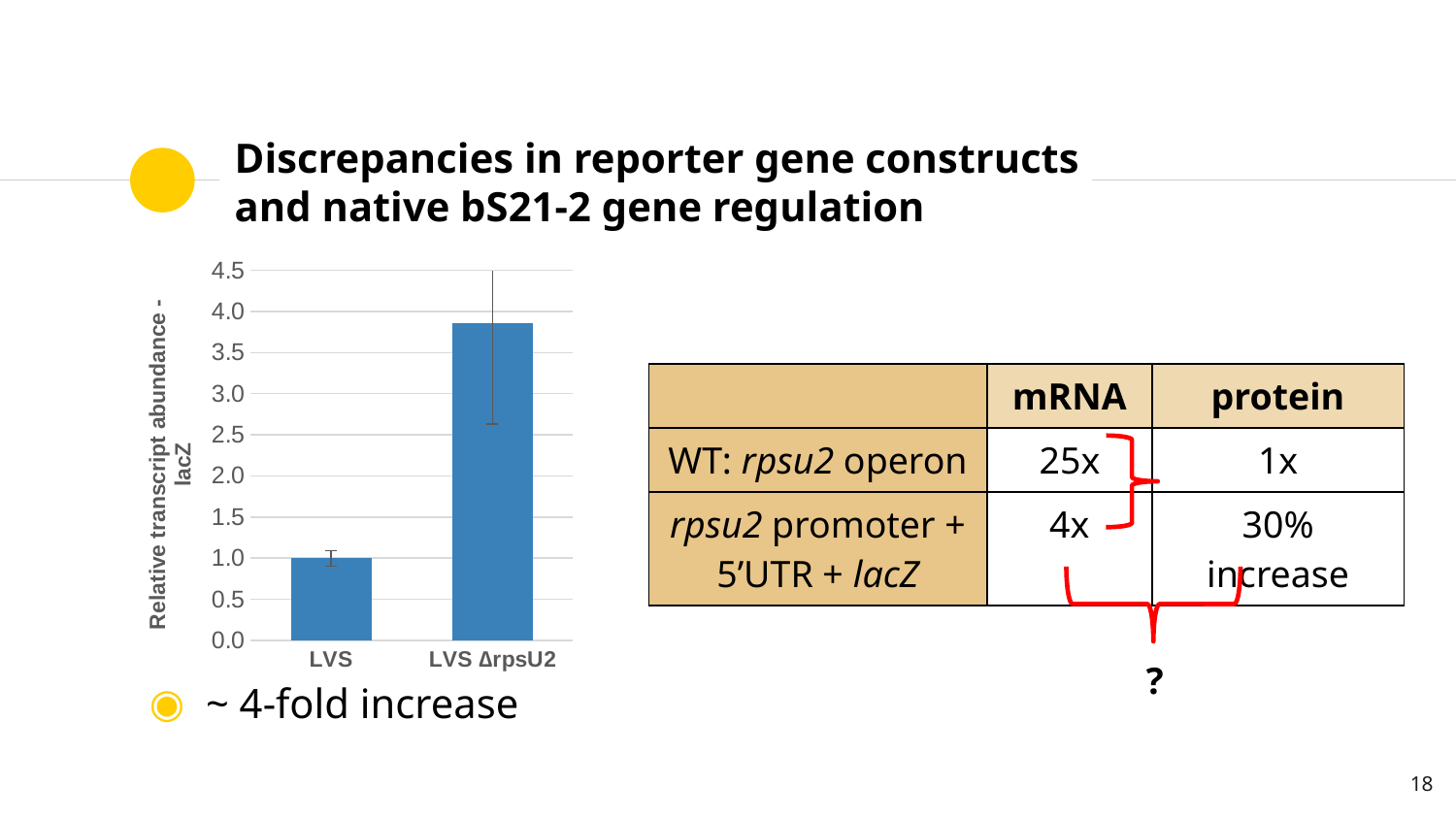
Is the value for LVS ΔrpsU2 greater or less than 4.0? less Which is larger, the value for LVS or the value for LVS ΔrpsU2? LVS ΔrpsU2 What is the highest tick value shown on the y axis? 4.5 Which category has the lowest relative transcript abundance? LVS Is the value for LVS greater or less than 2.0? less What is the relative transcript abundance value for LVS? 1.0 What is the label on the y axis of the bar chart? Relative transcript abundance - lacZ Which category has the highest relative transcript abundance? LVS ΔrpsU2 What kind of chart is shown on the slide? bar chart What colour are the bars in the chart? blue Is the value for LVS ΔrpsU2 greater or less than 3.0? greater How many categories are plotted on the x axis of the bar chart? 2